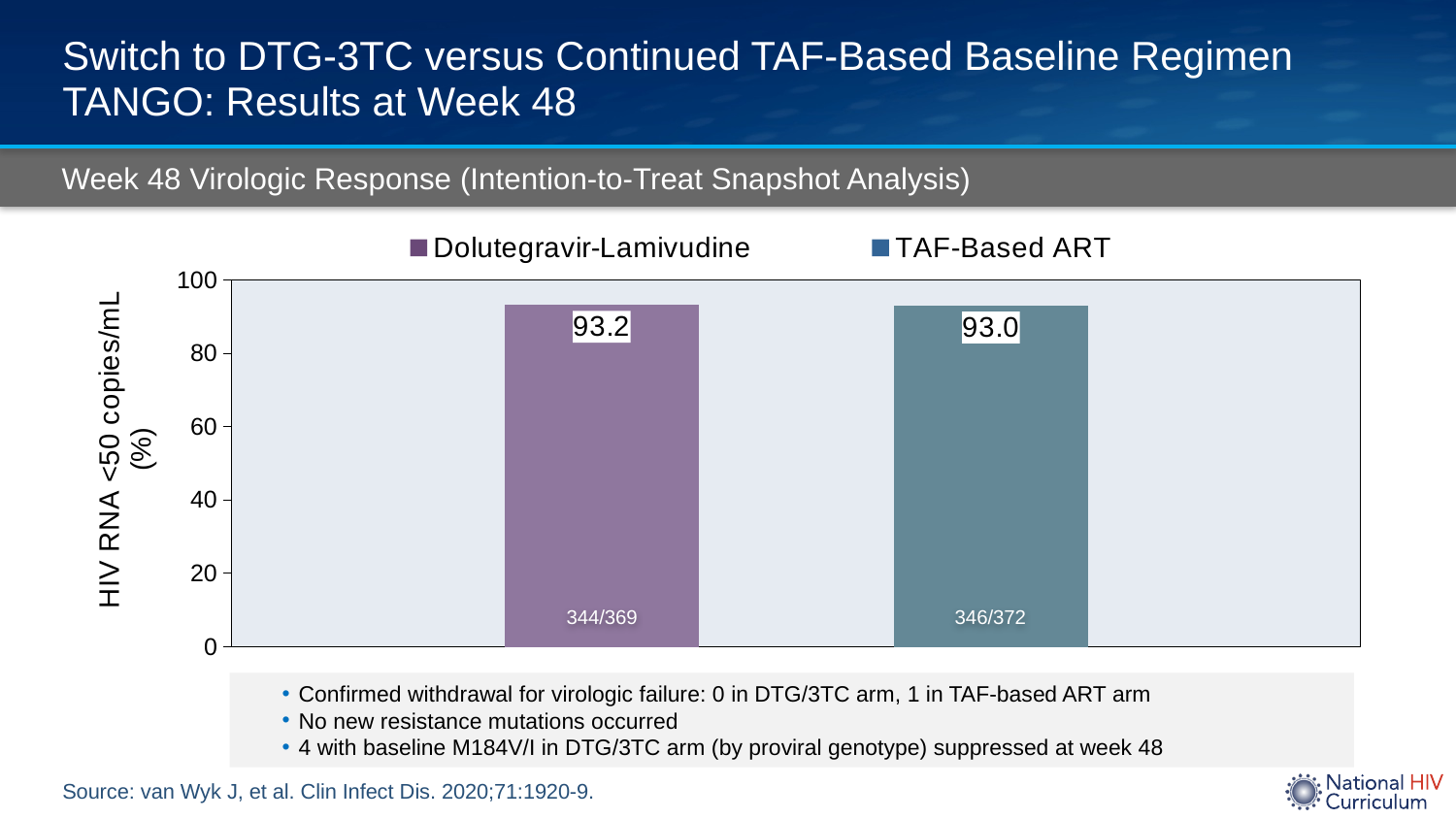
What fraction is printed inside the TAF-Based ART bar? 346/372 What is the value for Dolutegravir-Lamivudine in the Week 48 Virologic Response chart? 93.2 What fraction is printed inside the Dolutegravir-Lamivudine bar? 344/369 How many bars are plotted in the chart? 2 What is the value for TAF-Based ART in the Week 48 Virologic Response chart? 93.0 Is the value for Dolutegravir-Lamivudine greater or less than 100? less What is the title of the chart? Week 48 Virologic Response (Intention-to-Treat Snapshot Analysis) What is the difference between the Dolutegravir-Lamivudine value and the TAF-Based ART value? 0.2 What kind of chart is shown on the slide? Bar chart What is the label of the y axis? HIV RNA <50 copies/mL (%) Is the value for TAF-Based ART greater or less than 80? greater How many series does the legend list? 2